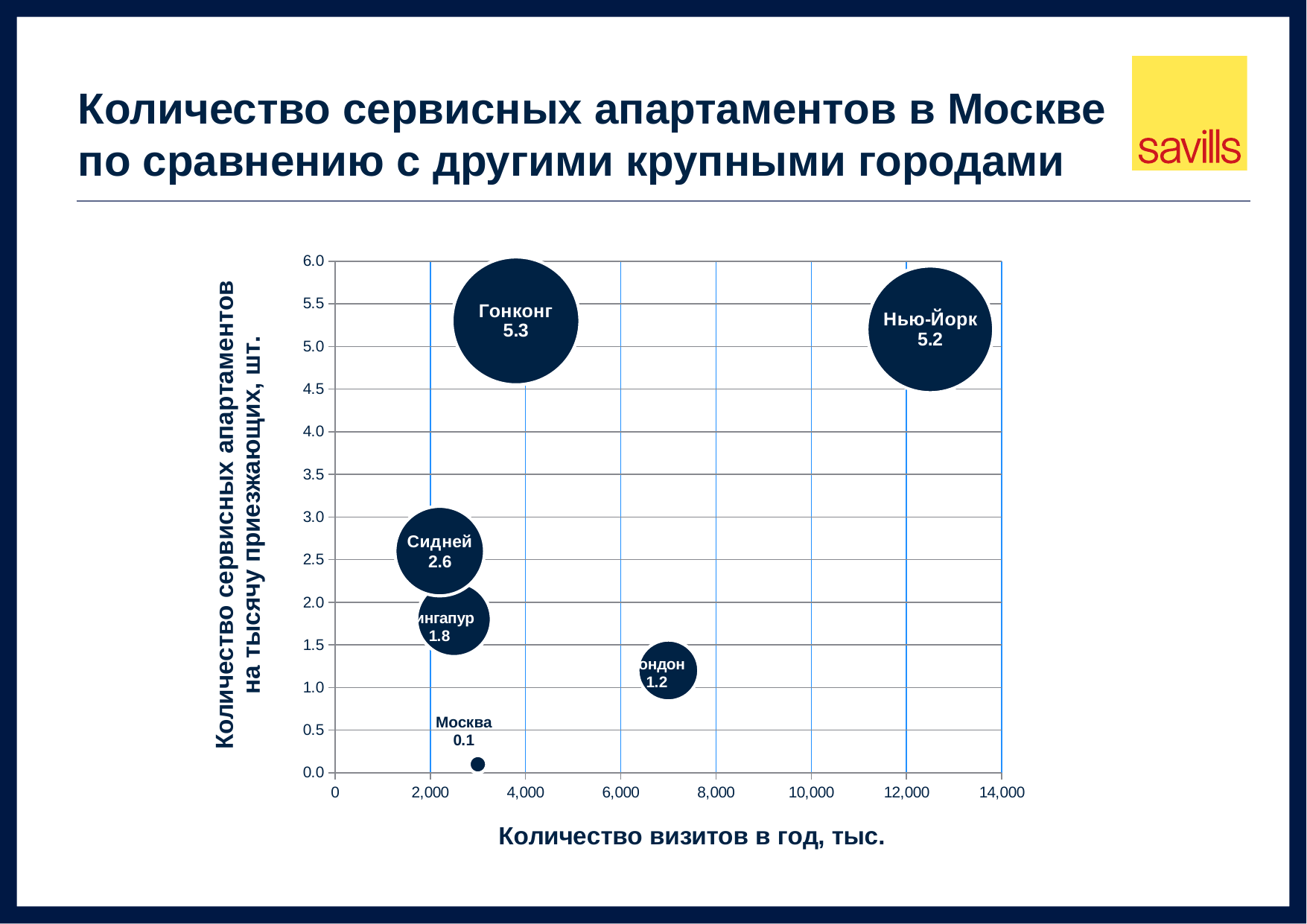
How many cities are plotted on the chart? 6 What is the number of serviced apartments per thousand visitors for Гонконг? 5.3 What value is shown for Сидней? 2.6 Which has a larger value, Сидней or Лондон? Сидней What is the difference between the values for Гонконг and Москва? 5.2 What kind of chart is shown on the slide? bubble chart What value is shown for Москва? 0.1 Which city has the lowest number of serviced apartments per thousand visitors? Москва Is the number of visits per year for Нью-Йорк greater or less than 12,000? greater What value is shown for Нью-Йорк? 5.2 Which city has the highest number of serviced apartments per thousand visitors? Гонконг